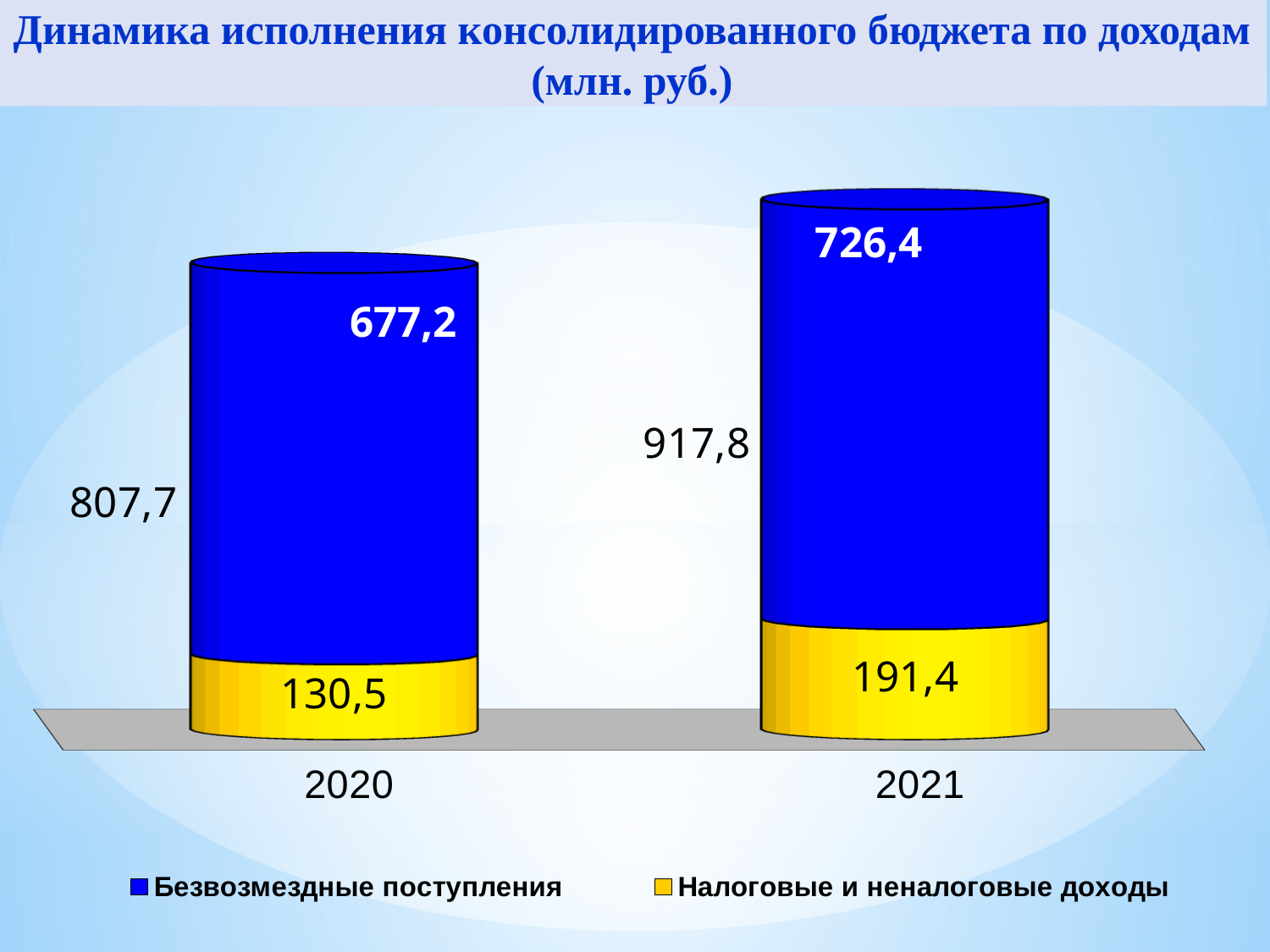
What is the difference between the Безвозмездные поступления values for 2021 and 2020? 49,2 What is the value of Налоговые и неналоговые доходы for 2020? 130,5 Which year has the higher total revenue, 2020 or 2021? 2021 Which year has the lowest value for Налоговые и неналоговые доходы? 2020 How many categories are shown on the x axis? 2 What is the total of the stacked bar for 2020? 807,7 What is the total of the stacked bar for 2021? 917,8 What is the value of Налоговые и неналоговые доходы for 2021? 191,4 What is the difference between the Налоговые и неналоговые доходы values for 2021 and 2020? 60,9 How many series does the legend list? 2 What kind of chart is shown on the slide? Stacked bar chart What is the value of Безвозмездные поступления for 2020? 677,2